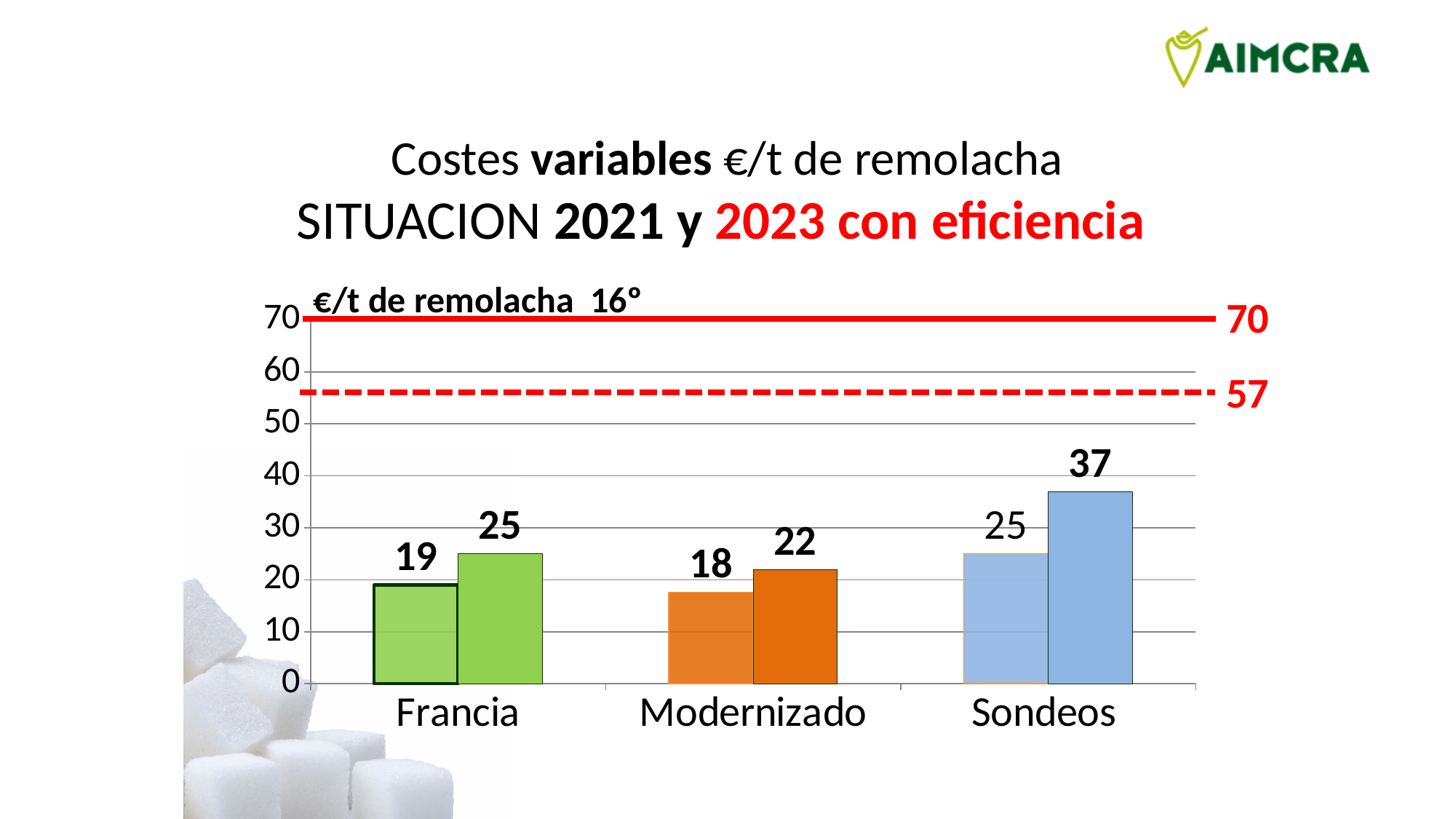
Which is larger: the right bar for Francia or the right bar for Modernizado? Francia What value is marked by the solid red horizontal line? 70 What is the difference between the right bar and the left bar for Francia? 6 Which category has the lowest bar in the chart? Modernizado What is the value of the left bar for Francia? 19 Which category has the highest bar in the chart? Sondeos How many categories are shown on the x axis? 3 What is the value of the left bar for Modernizado? 18 What kind of chart is shown on the slide? Bar chart What is the difference between the right bar and the left bar for Sondeos? 12 What is the value of the right bar for Modernizado? 22 What is the value of the right bar for Sondeos? 37